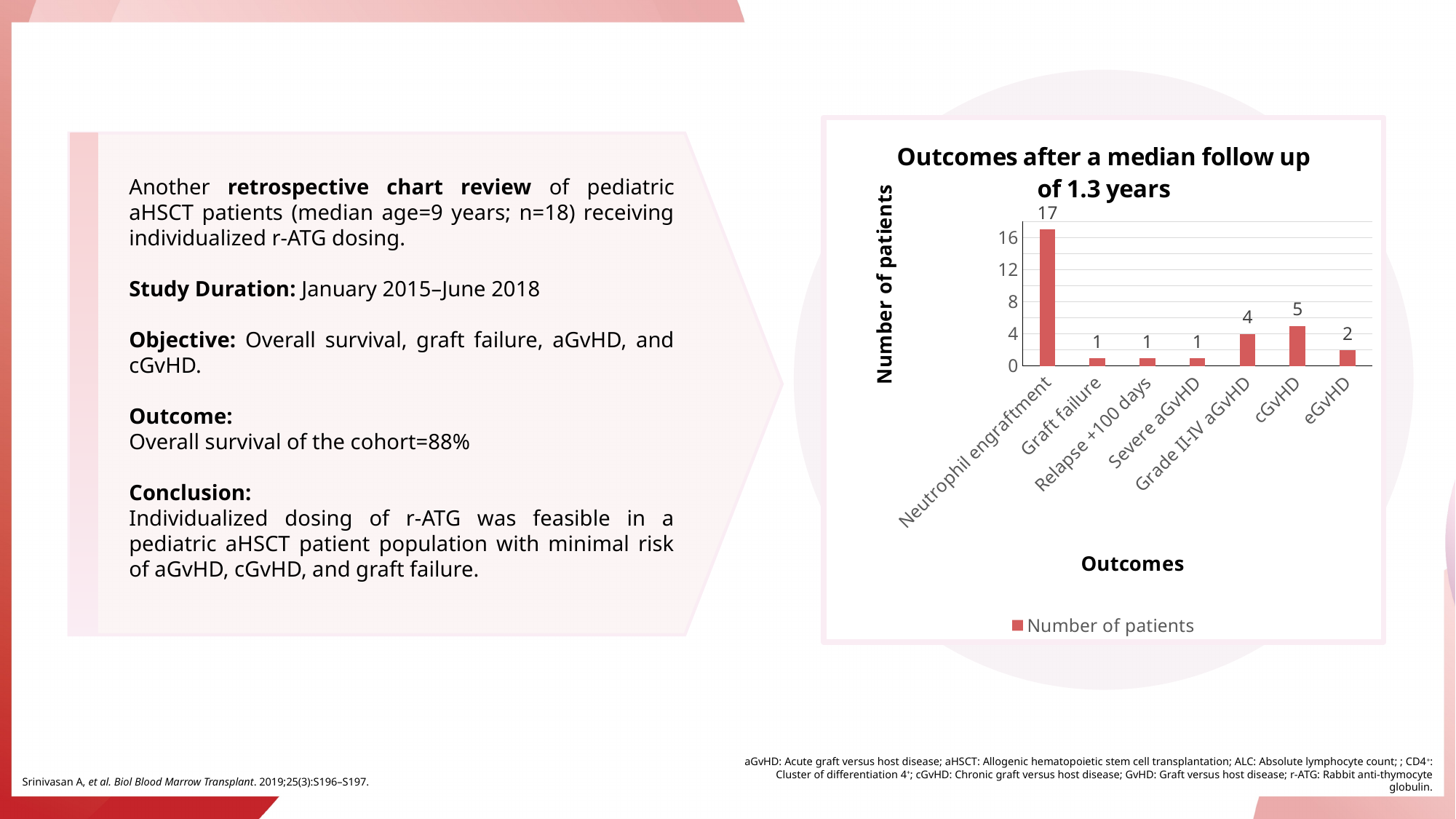
What kind of chart is shown on the slide? Bar chart What is the difference in number of patients between Neutrophil engraftment and cGvHD? 12 Is the value for Neutrophil engraftment greater or less than 12? greater Which has more patients, Grade II-IV aGvHD or eGvHD? Grade II-IV aGvHD What is the number of patients for eGvHD? 2 How many series does the legend list? 1 What is the number of patients for cGvHD? 5 What is the title of the chart? Outcomes after a median follow up of 1.3 years What is the number of patients for Grade II-IV aGvHD? 4 Which outcome has the highest number of patients? Neutrophil engraftment How many outcome categories are shown on the x axis? 7 What is the number of patients for Neutrophil engraftment? 17